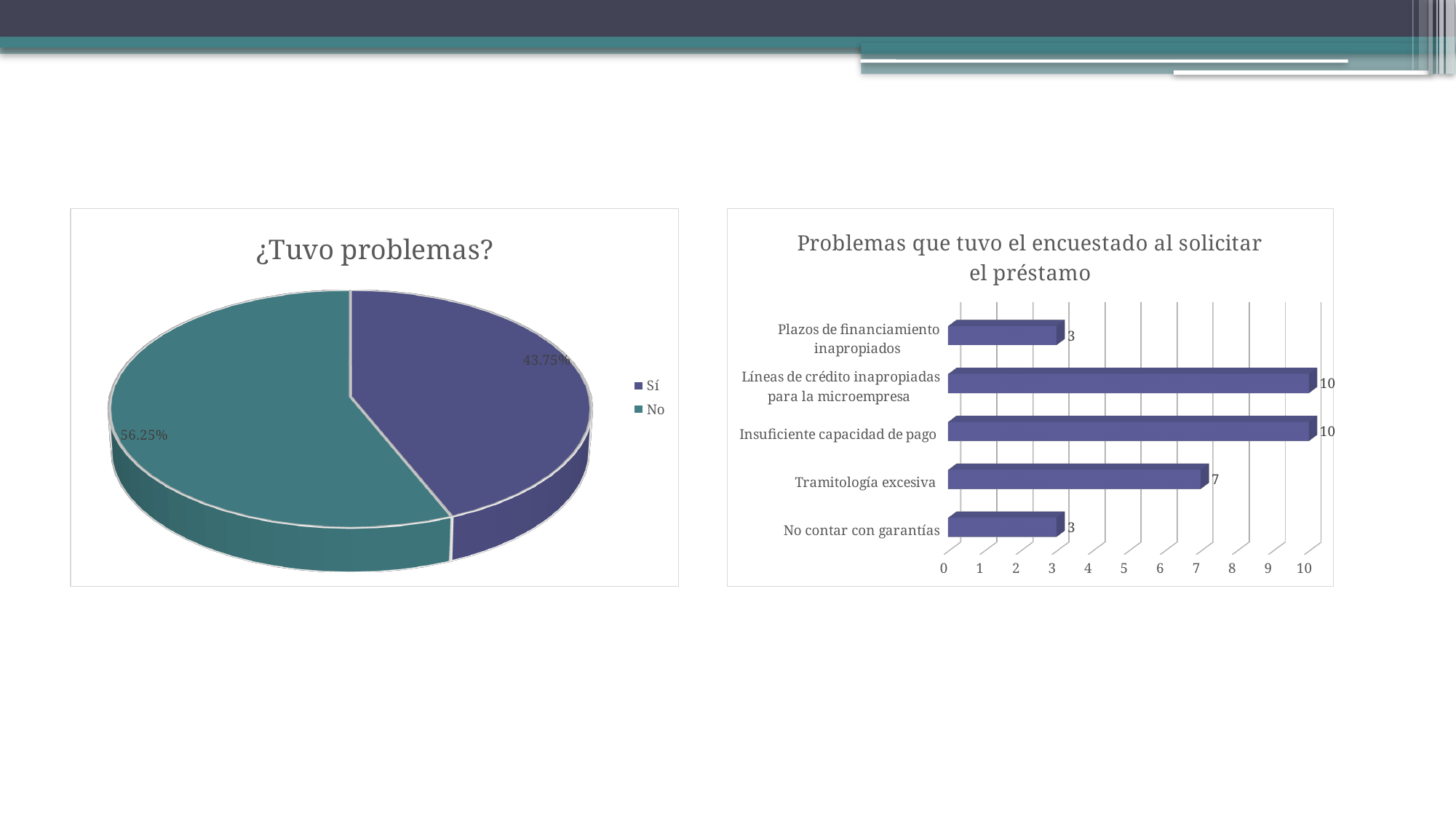
In the '¿Tuvo problemas?' chart, what share of respondents answered 'No'? 56.25% In the 'Problemas que tuvo el encuestado al solicitar el préstamo' chart, what is the value for 'No contar con garantías'? 3 How many entries does the legend of the '¿Tuvo problemas?' chart list? 2 What kind of chart is 'Problemas que tuvo el encuestado al solicitar el préstamo'? Bar chart In the 'Problemas que tuvo el encuestado al solicitar el préstamo' chart, what is the difference between 'Líneas de crédito inapropiadas para la microempresa' and 'Plazos de financiamiento inapropiados'? 7 In the 'Problemas que tuvo el encuestado al solicitar el préstamo' chart, which is larger, 'Tramitología excesiva' or 'No contar con garantías'? Tramitología excesiva What kind of chart is '¿Tuvo problemas?'? Pie chart In the 'Problemas que tuvo el encuestado al solicitar el préstamo' chart, how many categories are shown? 5 In the 'Problemas que tuvo el encuestado al solicitar el préstamo' chart, what is the value for 'Tramitología excesiva'? 7 In the '¿Tuvo problemas?' chart, what share of respondents answered 'Sí'? 43.75% In the '¿Tuvo problemas?' chart, which slice is larger, 'Sí' or 'No'? No In the 'Problemas que tuvo el encuestado al solicitar el préstamo' chart, what is the value for 'Insuficiente capacidad de pago'? 10